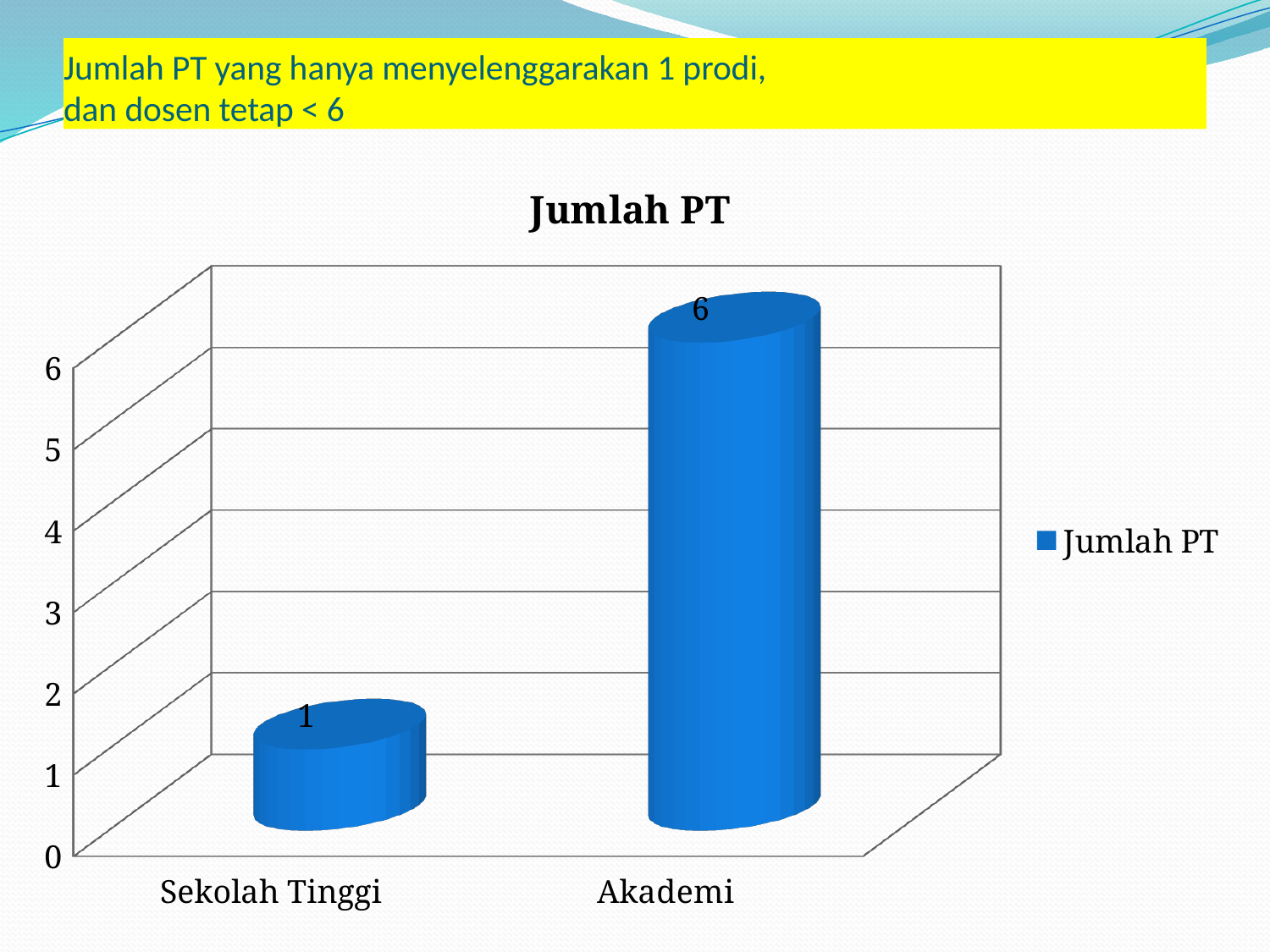
Is the value for Sekolah Tinggi greater or less than 3? less What is the value for Sekolah Tinggi? 1 What kind of chart is shown on the slide? bar chart Which category has the highest value? Akademi How many categories are shown on the x axis? 2 Which is larger, the value for Sekolah Tinggi or the value for Akademi? Akademi What is the value for Akademi? 6 Which category has the lowest value? Sekolah Tinggi What is the difference between the values for Akademi and Sekolah Tinggi? 5 Is the value for Akademi greater or less than 4? greater What is the title of the chart? Jumlah PT How many series does the legend list? 1